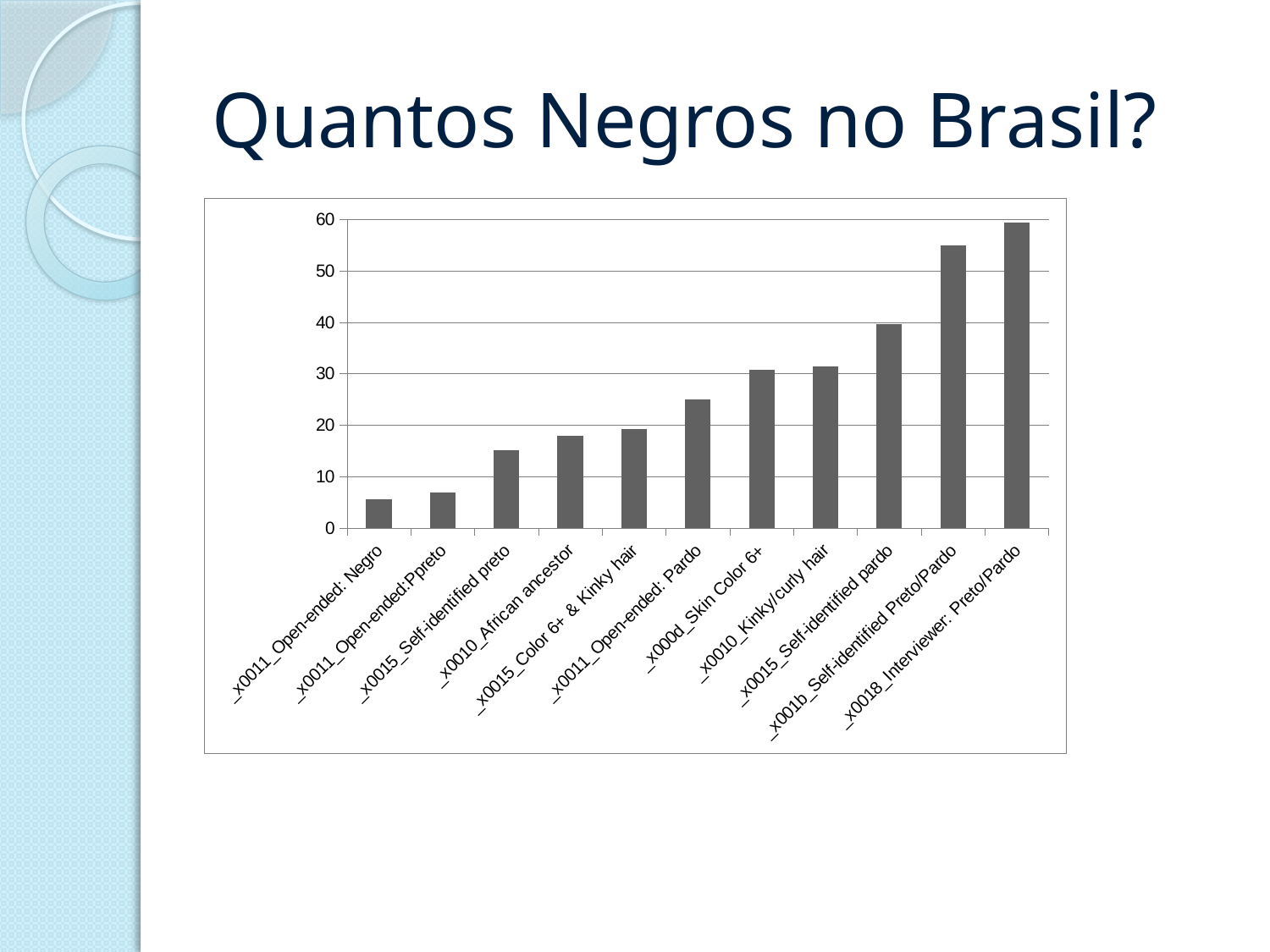
Which is larger, the value for _x001b_Self-identified Preto/Pardo or the value for _x0015_Self-identified pardo? _x001b_Self-identified Preto/Pardo Which category has the highest value in the chart? _x0018_Interviewer: Preto/Pardo How many categories are plotted in the chart? 11 Is the value for _x000d_Skin Color 6+ greater or less than 40? less Is the value for _x0010_African ancestor greater or less than 20? less Do the values rise or fall moving from left to right along the x axis? rise What is the title of the slide containing the chart? Quantos Negros no Brasil? Is the value for _x001b_Self-identified Preto/Pardo greater or less than 50? greater What kind of chart is shown on the slide? bar chart Which category has the lowest value in the chart? _x0011_Open-ended: Negro